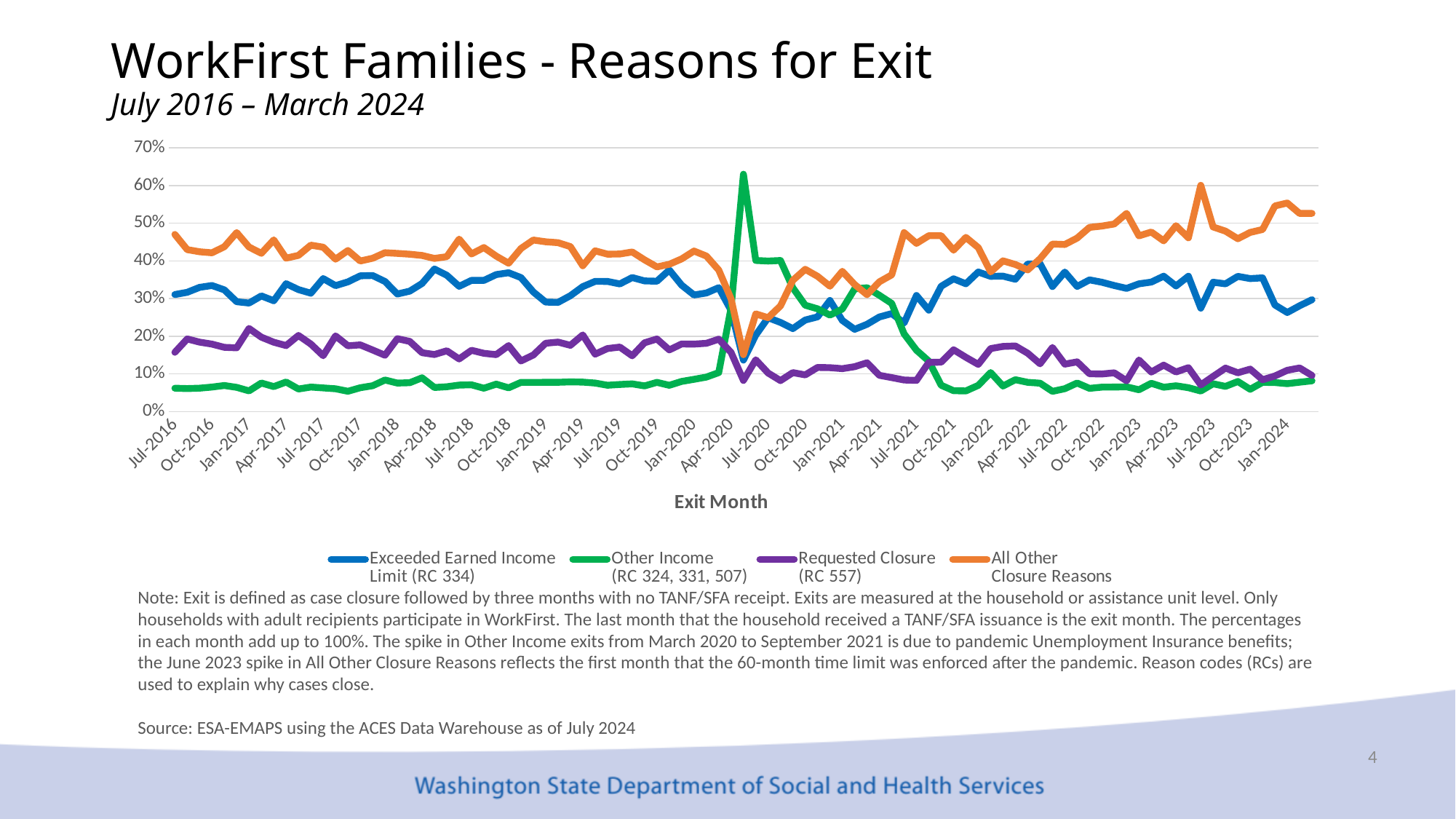
Does the Other Income (RC 324, 331, 507) line rise or fall from Jul-2020 to Oct-2021? fall Which series has the highest value at Jul-2016? All Other Closure Reasons What kind of chart is shown on the slide? line chart Which legend entry corresponds to the green line? Other Income (RC 324, 331, 507) How many series does the legend list? 4 Is the value for Requested Closure (RC 557) at Jan-2024 greater or less than 20%? less At Jul-2016, which is higher: Exceeded Earned Income Limit (RC 334) or Other Income (RC 324, 331, 507)? Exceeded Earned Income Limit (RC 334) At Jan-2024, which is higher: All Other Closure Reasons or Exceeded Earned Income Limit (RC 334)? All Other Closure Reasons Is the peak value of Other Income around Jul-2020 greater or less than 50%? greater Is the value for All Other Closure Reasons at its Jul-2023 spike greater or less than 50%? greater What is the title of the x axis? Exit Month Which series has the lowest value at Jul-2016? Other Income (RC 324, 331, 507)